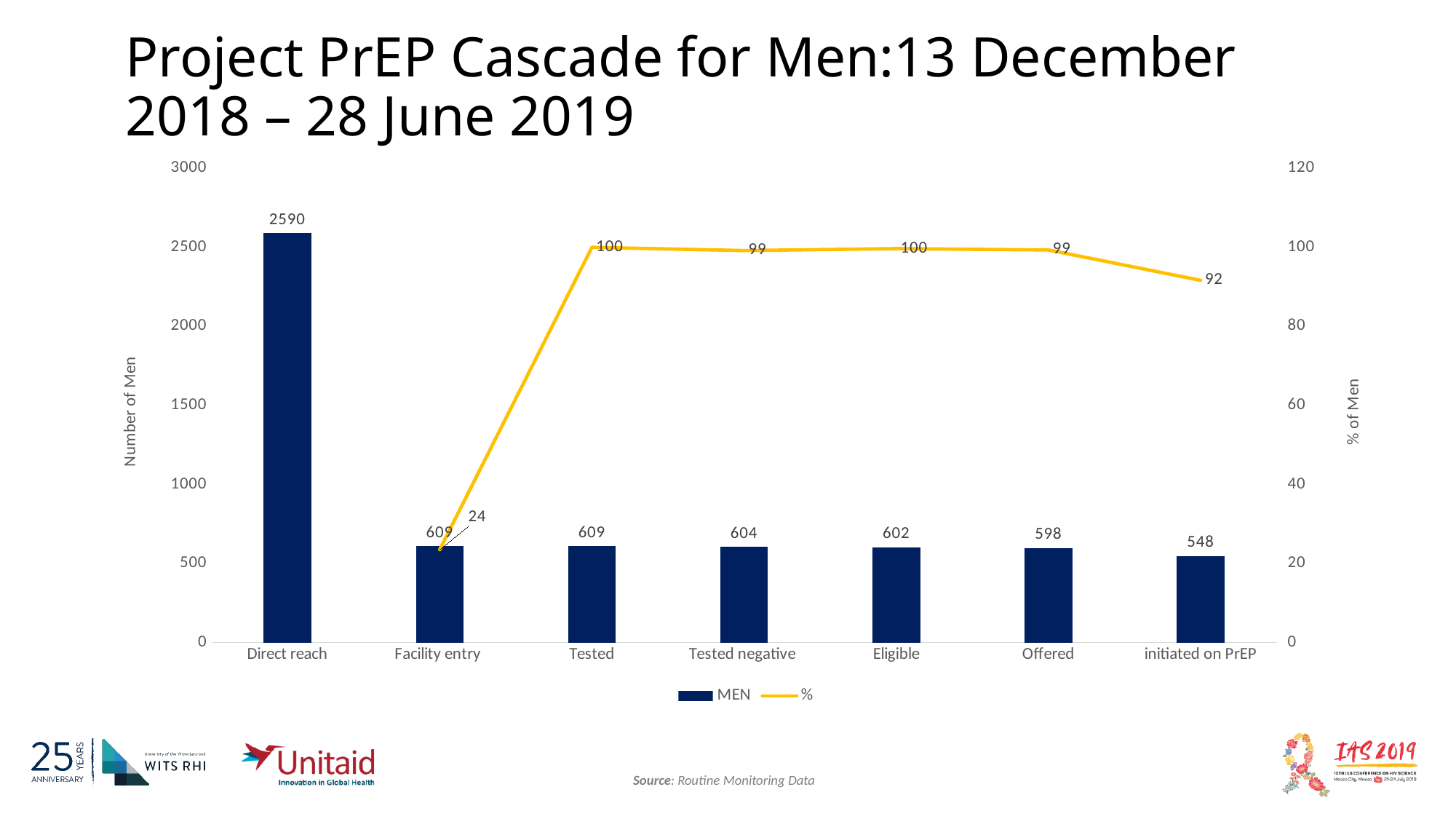
What is the difference in number of men between Direct reach and Facility entry? 1981 What is the number of men initiated on PrEP? 548 Which category has the highest number of men? Direct reach What percentage of men is shown for initiated on PrEP? 92 Which has more men, Tested negative or Eligible? Tested negative What is the difference in number of men between Offered and initiated on PrEP? 50 How many categories are shown on the x axis? 7 What percentage of men is shown for Facility entry? 24 What is the label of the left vertical axis? Number of Men What is the number of men for Direct reach? 2590 Which category has the lowest number of men? initiated on PrEP How many series does the legend list? 2